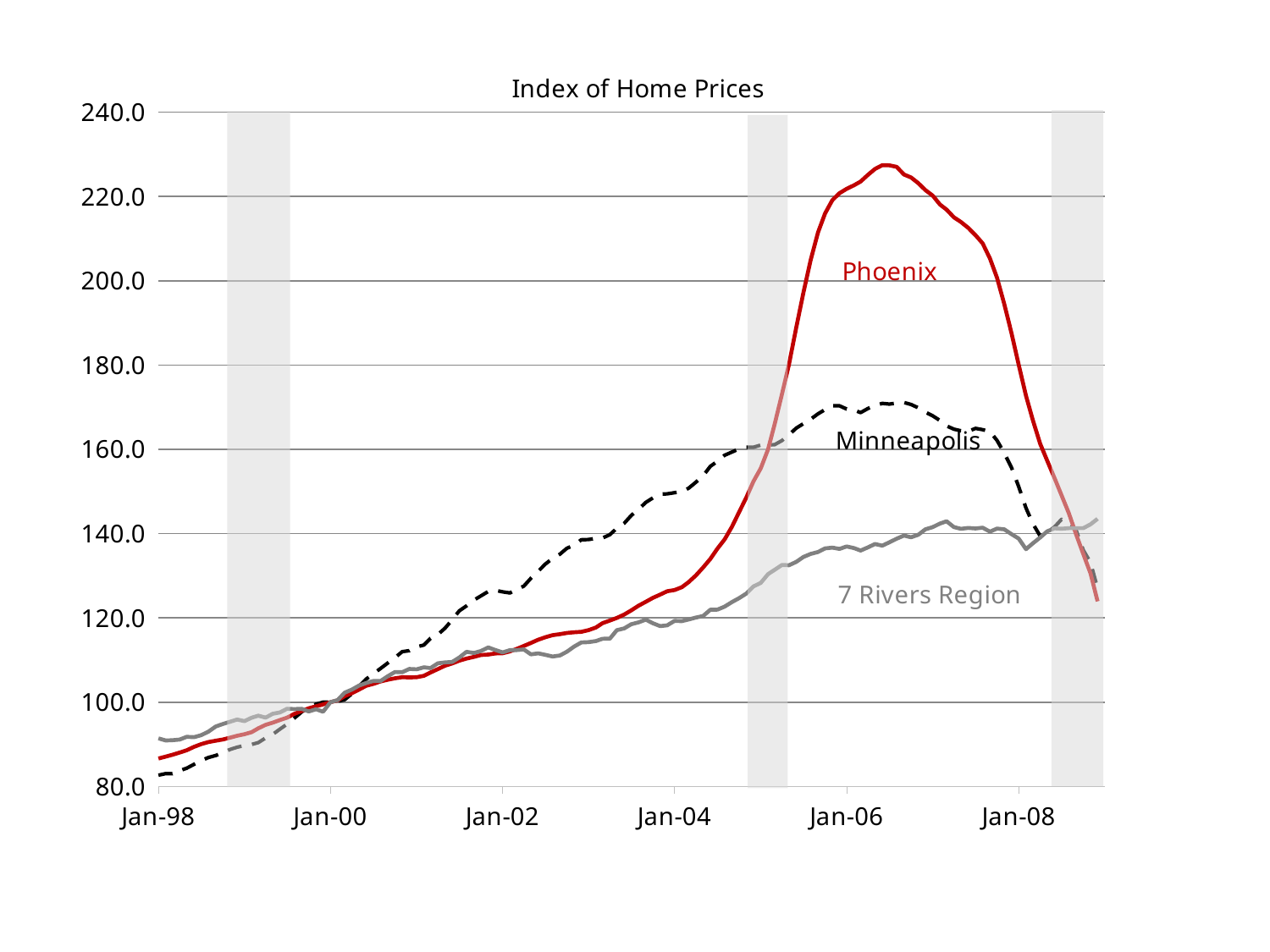
Which series has the highest value at Jan-98? 7 Rivers Region What kind of chart is shown on the slide? line chart Which series has the lowest value at Jan-06? 7 Rivers Region Is the value for Minneapolis at Jan-98 greater or less than 100.0? less At Jan-02, which series is higher, Minneapolis or Phoenix? Minneapolis What is the title of the chart? Index of Home Prices How many series are plotted on the chart? 3 Is the value for 7 Rivers Region at Jan-06 greater or less than 140.0? less Does the Phoenix series rise or fall between Jan-04 and Jan-06? rise Is the value for Phoenix at Jan-06 greater or less than 200.0? greater Which series reaches the highest value on the chart? Phoenix What colour is the Phoenix line? red